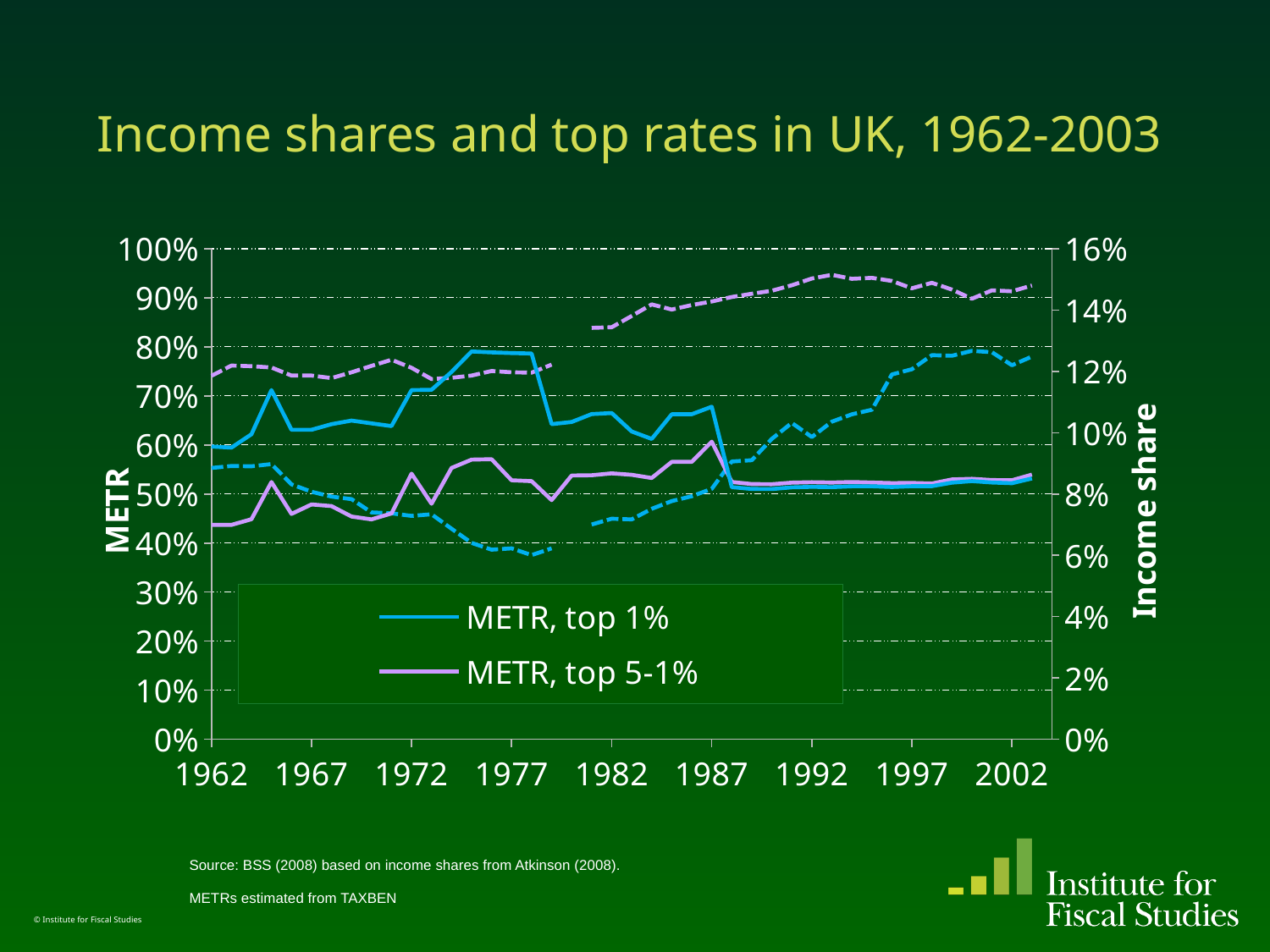
Is the value for METR, top 5-1% in 1977 greater or less than 50%? greater What kind of chart is shown on the slide? line chart In 1976, which is larger: METR, top 1% or METR, top 5-1%? METR, top 1% Is the value for METR, top 5-1% in 1962 greater or less than 50%? less How many series does the legend list? 2 What is the label on the right-hand vertical axis? Income share Is the value for METR, top 1% in 1976 greater or less than 70%? greater In 1962, which is larger: METR, top 1% or METR, top 5-1%? METR, top 1% What is the title of the chart? Income shares and top rates in UK, 1962-2003 Does the METR, top 1% series rise or fall between 1987 and 1989? fall